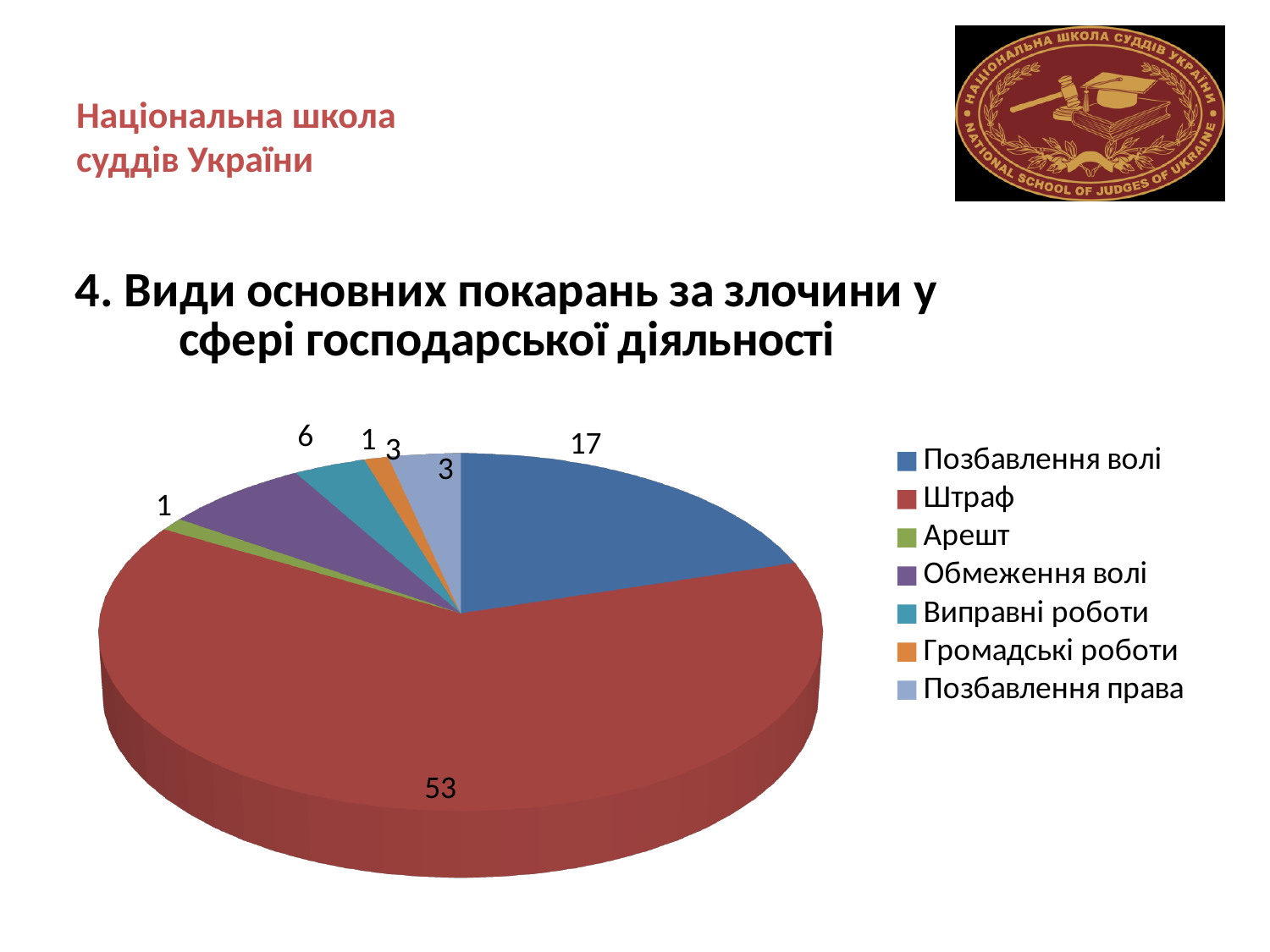
How many categories does the legend list? 7 Which colour represents Штраф in the pie chart? red What is the value for Штраф? 53 What is the difference between the values for Позбавлення волі and Обмеження волі? 11 Which category has the largest slice of the pie? Штраф What type of chart is shown on the slide? pie chart What is the title of the chart? 4. Види основних покарань за злочини у сфері господарської діяльності What is the value for Позбавлення волі? 17 Which is larger, the value for Позбавлення волі or the value for Обмеження волі? Позбавлення волі What is the value for Арешт? 1 What is the value for Обмеження волі? 6 What is the difference between the values for Штраф and Позбавлення волі? 36